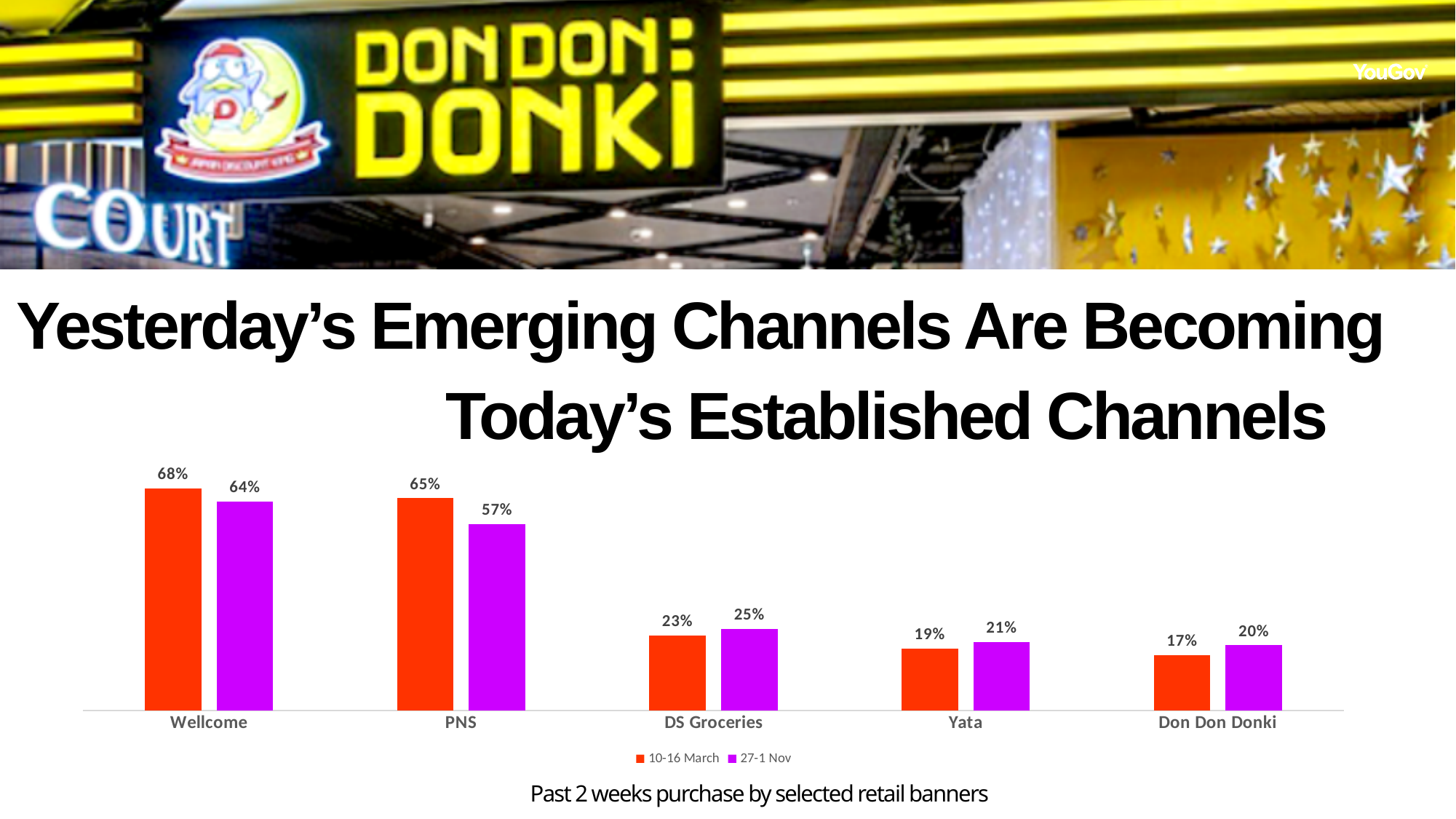
What is the value for PNS in the 27-1 Nov series? 57% What is the value for Don Don Donki in the 27-1 Nov series? 20% Which category has the lowest value in the 27-1 Nov series? Don Don Donki What kind of chart is shown on the slide? Bar chart How many series does the legend list? 2 Do the 27-1 Nov values rise or fall from Wellcome to Don Don Donki along the x axis? Fall What is the difference between the 10-16 March and 27-1 Nov values for PNS? 8% Which category has the highest value in the 10-16 March series? Wellcome What is the value for Wellcome in the 10-16 March series? 68% What colour are the bars for the 27-1 Nov series? Purple Which is larger for Yata: the 10-16 March value or the 27-1 Nov value? 27-1 Nov How many retail banners are shown on the x axis? 5